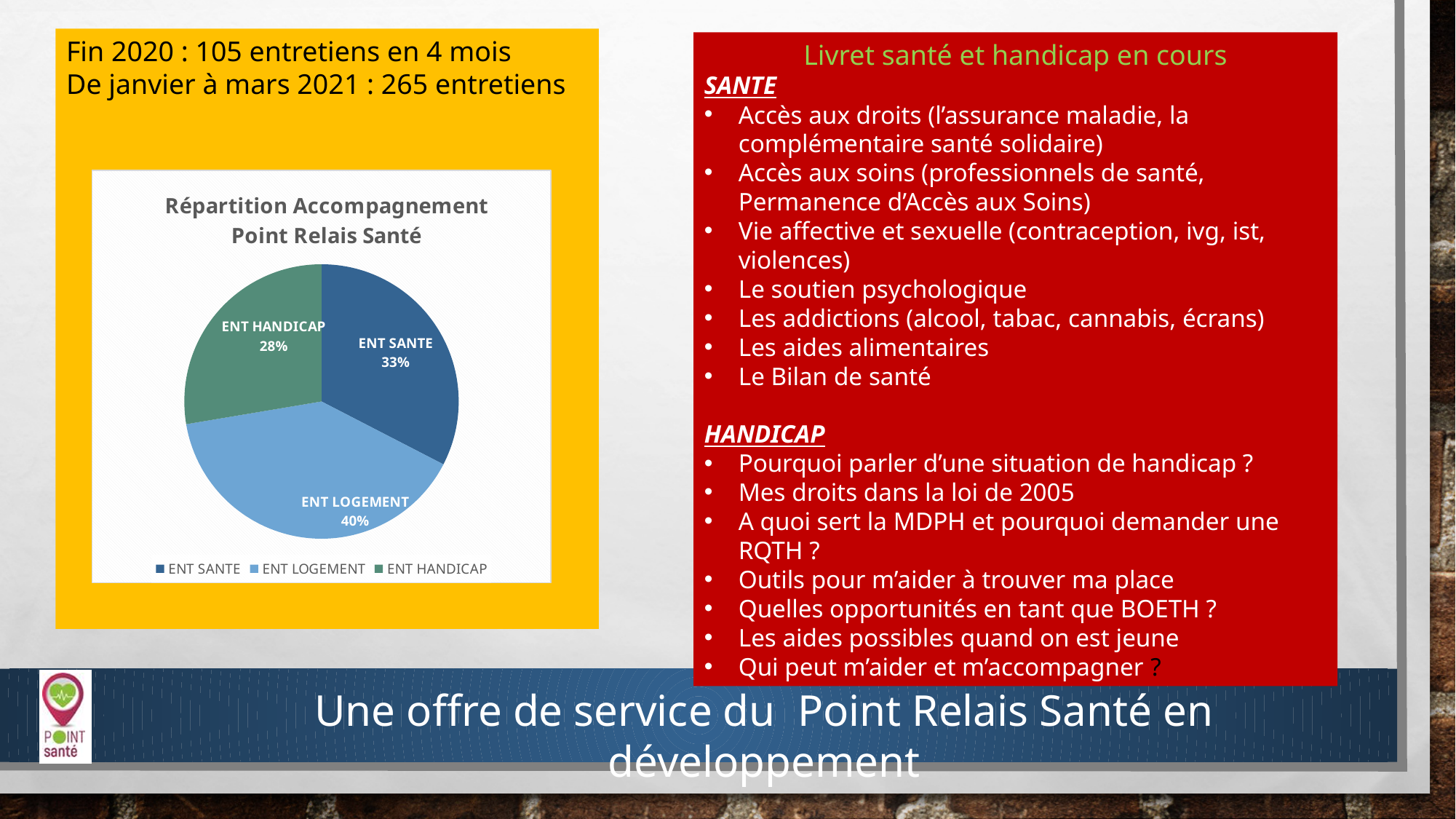
What share of the pie does ENT SANTE represent? 33% What share of the pie does ENT LOGEMENT represent? 40% Which is larger, the share for ENT SANTE or the share for ENT HANDICAP? ENT SANTE What is the difference in percentage points between ENT LOGEMENT and ENT HANDICAP? 12 What colour is the ENT LOGEMENT slice? light blue Which category has the smallest share of the pie? ENT HANDICAP What share of the pie does ENT HANDICAP represent? 28% Which category has the largest share of the pie? ENT LOGEMENT How many entries does the legend list? 3 How many categories are shown in the pie chart? 3 What type of chart is shown on the slide? pie chart What is the title of the chart? Répartition Accompagnement Point Relais Santé